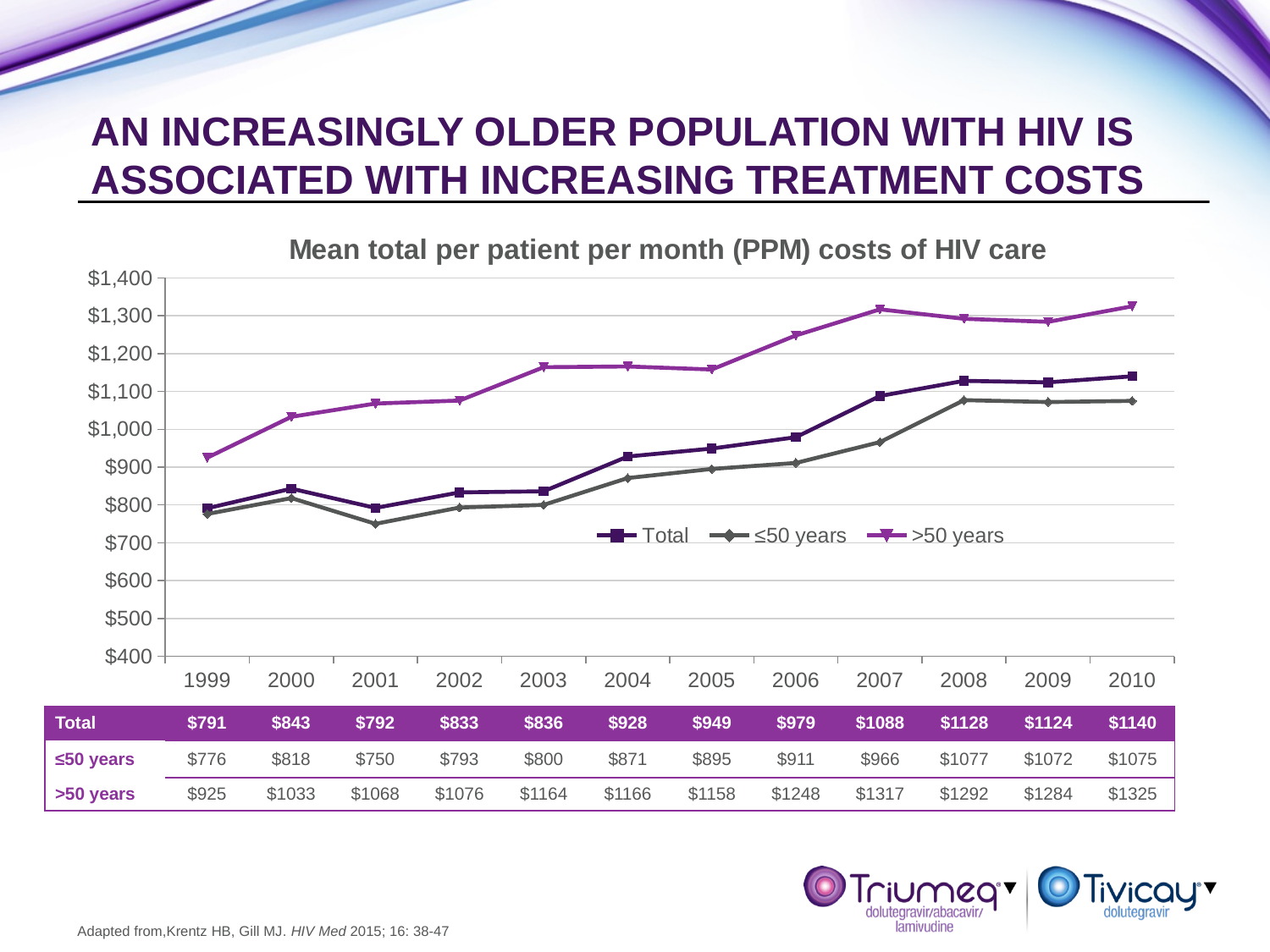
By how much did the Total cost increase from 1999 to 2010? $349 In which year is the ≤50 years cost lowest? 2001 What is the mean PPM cost for the >50 years group in 2007? $1317 What is the mean PPM cost for the ≤50 years group in 2001? $750 How many series does the legend list? 3 How many years are plotted on the x axis? 12 Is the value for the >50 years group in 2007 greater or less than $1,300? greater Which is larger: the >50 years cost in 2006 or the Total cost in 2010? >50 years cost in 2006 What is the difference between the >50 years and ≤50 years costs in 2010? $250 In which year is the >50 years cost highest? 2010 What is the Total mean PPM cost in 2010? $1140 What kind of chart is shown on the slide? Line chart